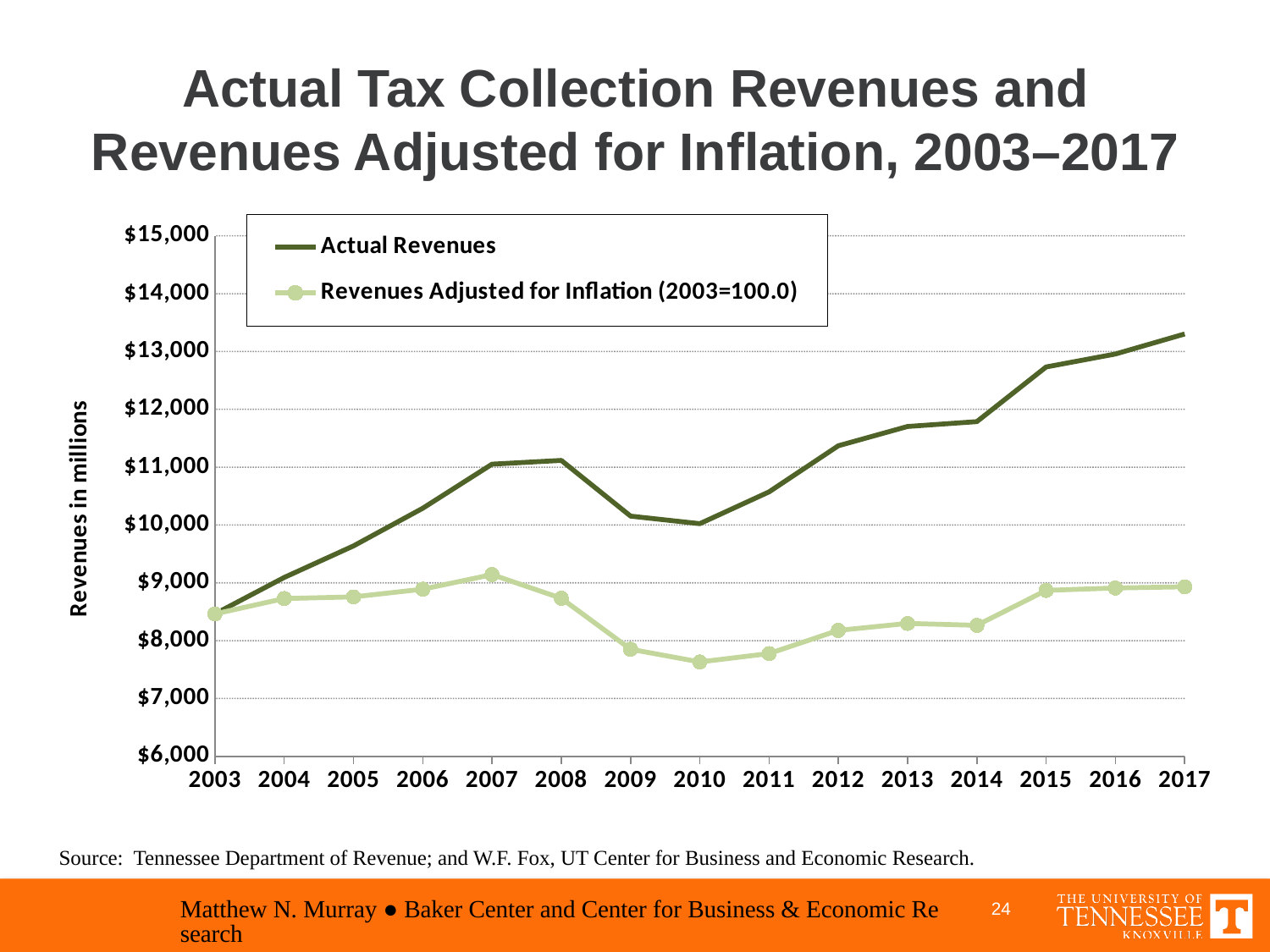
Is the Actual Revenues value for 2017 greater or less than $13,000? greater Is the Revenues Adjusted for Inflation value for 2010 greater or less than $8,000? less How many series does the legend list? 2 Which is larger: Revenues Adjusted for Inflation in 2007 or in 2010? 2007 In which year is the Actual Revenues series highest? 2017 In which year is the Actual Revenues series lowest? 2003 What kind of chart is shown on the slide? line chart How many years are plotted along the x axis? 15 Is the Actual Revenues value for 2015 greater or less than $12,000? greater In which year is the Revenues Adjusted for Inflation series highest? 2007 What is the label on the y axis? Revenues in millions Do Actual Revenues rise or fall from 2010 to 2017? rise